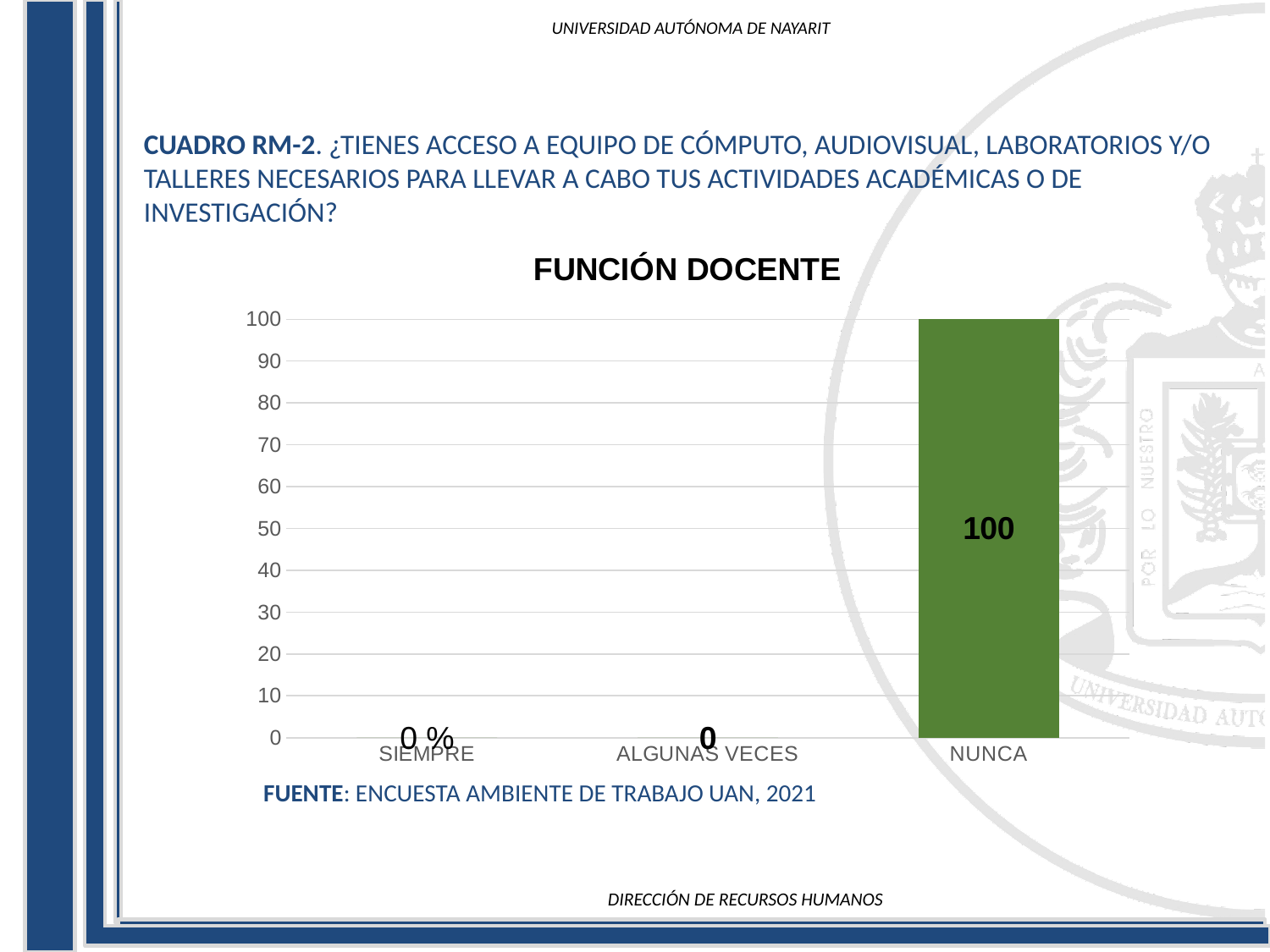
What is the highest value shown on the y axis of the FUNCIÓN DOCENTE chart? 100 What kind of chart is the FUNCIÓN DOCENTE chart? bar chart What is the value for ALGUNAS VECES in the FUNCIÓN DOCENTE chart? 0 What is the title of the chart on the slide? FUNCIÓN DOCENTE How many categories are shown on the x axis of the FUNCIÓN DOCENTE chart? 3 What data label is shown for SIEMPRE in the FUNCIÓN DOCENTE chart? 0 % Which is larger in the FUNCIÓN DOCENTE chart, the value for NUNCA or the value for SIEMPRE? NUNCA Is the value for NUNCA in the FUNCIÓN DOCENTE chart greater or less than 50? greater Do the values rise or fall from SIEMPRE to NUNCA in the FUNCIÓN DOCENTE chart? rise What is the difference between the values for NUNCA and ALGUNAS VECES in the FUNCIÓN DOCENTE chart? 100 Which category has the highest value in the FUNCIÓN DOCENTE chart? NUNCA What is the value for NUNCA in the FUNCIÓN DOCENTE chart? 100